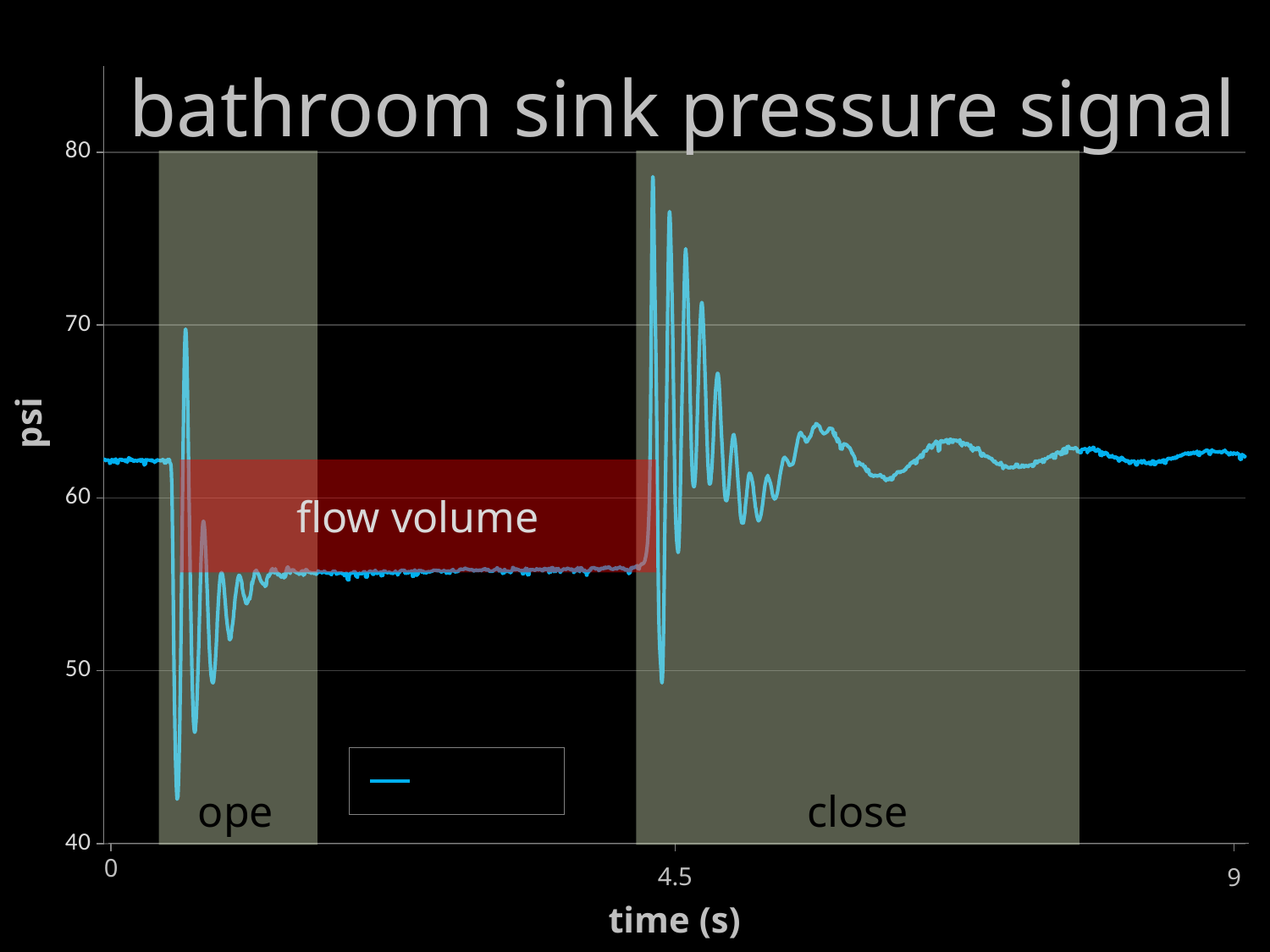
Is the highest pressure peak in the 'close' region greater or less than 70 psi? greater What is the title of the chart? bathroom sink pressure signal What is the label of the x axis? time (s) Is the lowest pressure dip in the 'ope' region greater or less than 50 psi? less What kind of chart is shown on the slide? line chart Is the pressure at time 0 greater or less than 60 psi? greater Which shaded region contains the higher pressure peak, 'ope' or 'close'? close What is the label of the y axis? psi How many series does the legend list? 1 Which shaded region contains the lower pressure dip, 'ope' or 'close'? ope